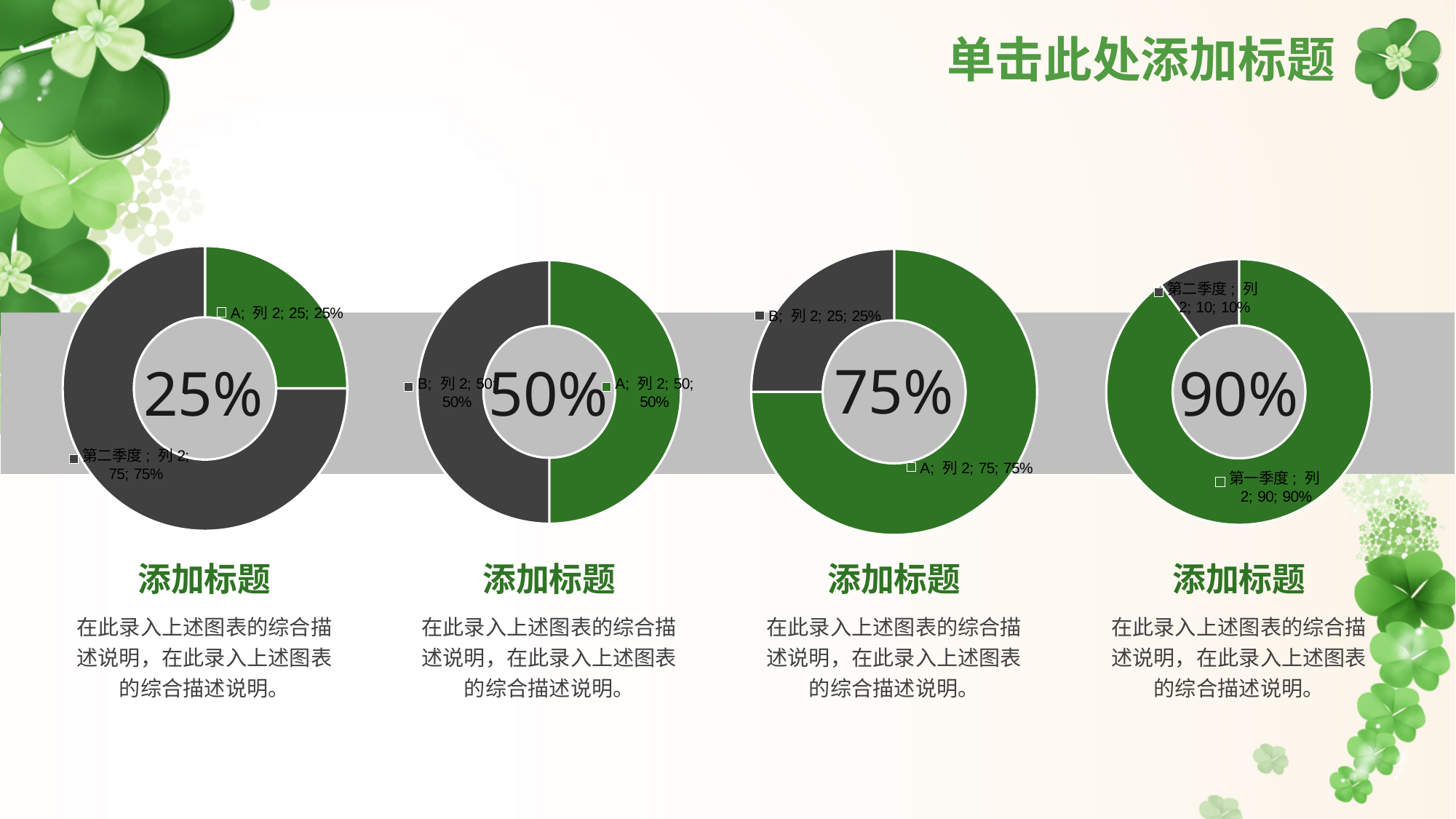
In the rightmost chart (90% in the centre), what colour is the slice for 第一季度? green In the rightmost chart (90% in the centre), what value is shown for 第一季度? 90 In the third chart from the left (75% in the centre), which category has the larger value, A or B? A In the third chart from the left (75% in the centre), what is the difference between the values for A and B? 50 How many slices does the leftmost chart (25% in the centre) have? 2 In the third chart from the left (75% in the centre), what share of the doughnut does B take? 25% What kind of chart is the leftmost chart showing 25% in the centre? doughnut chart In the leftmost chart (25% in the centre), what share of the doughnut does 第二季度 take? 75% In the second chart from the left (50% in the centre), what is the total of the values for A and B? 100 In the leftmost chart (25% in the centre), what value is shown for category A? 25 In the second chart from the left (50% in the centre), what value is shown for category B? 50 In the rightmost chart (90% in the centre), which category has the smallest value? 第二季度